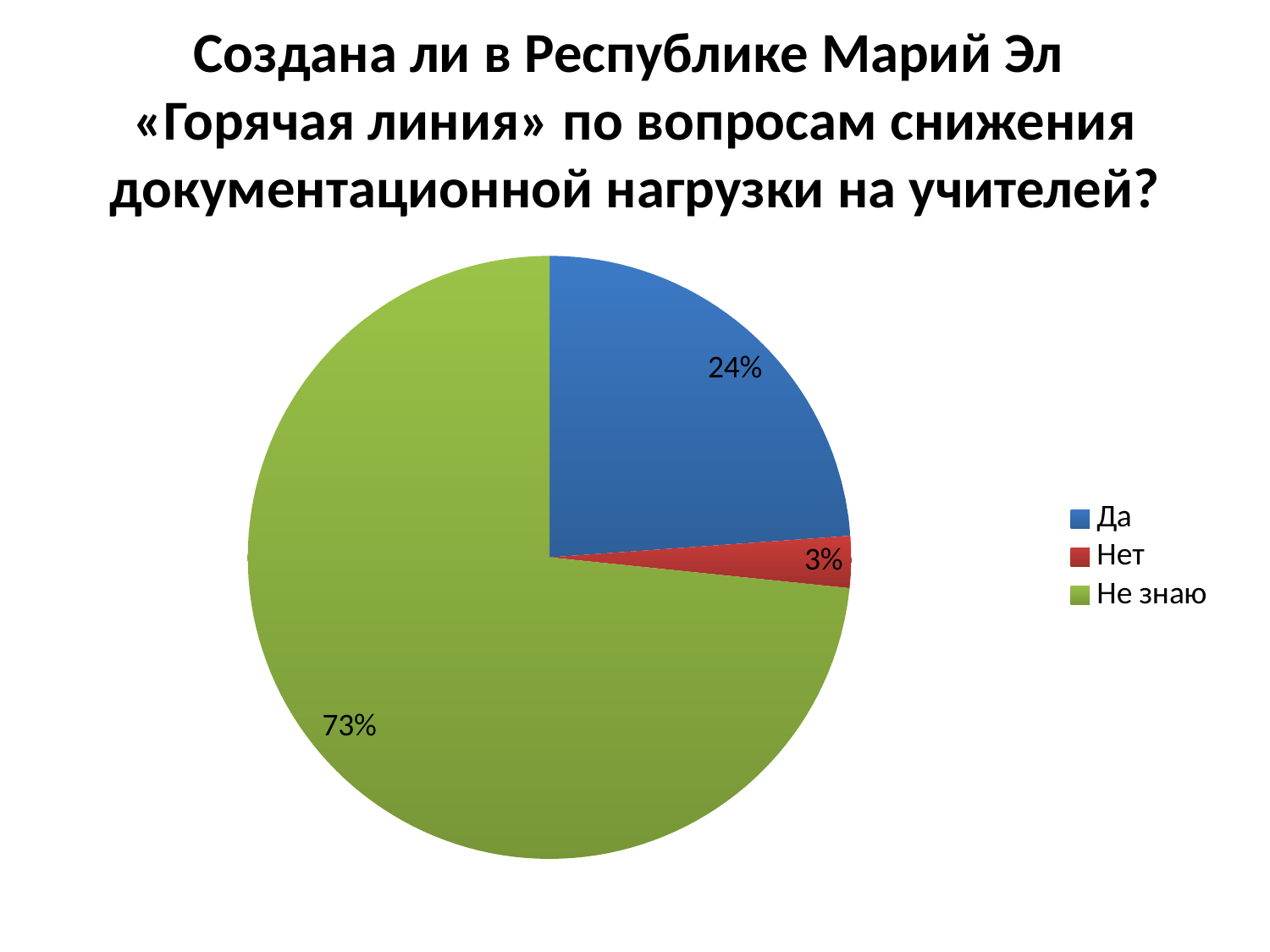
What colour is the slice for "Не знаю"? Green Which is larger, the share for "Да" or the share for "Нет"? Да What share of the pie does "Нет" represent? 3% What is the difference between the shares for "Да" and "Нет"? 21% Which category has the smallest slice of the pie? Нет How many categories does the pie chart show? 3 What share of the pie does "Не знаю" represent? 73% What share of the pie does "Да" represent? 24% What kind of chart is shown on the slide? Pie chart What colour is the slice for "Да"? Blue What is the difference between the shares for "Не знаю" and "Да"? 49% Which category has the largest slice of the pie? Не знаю